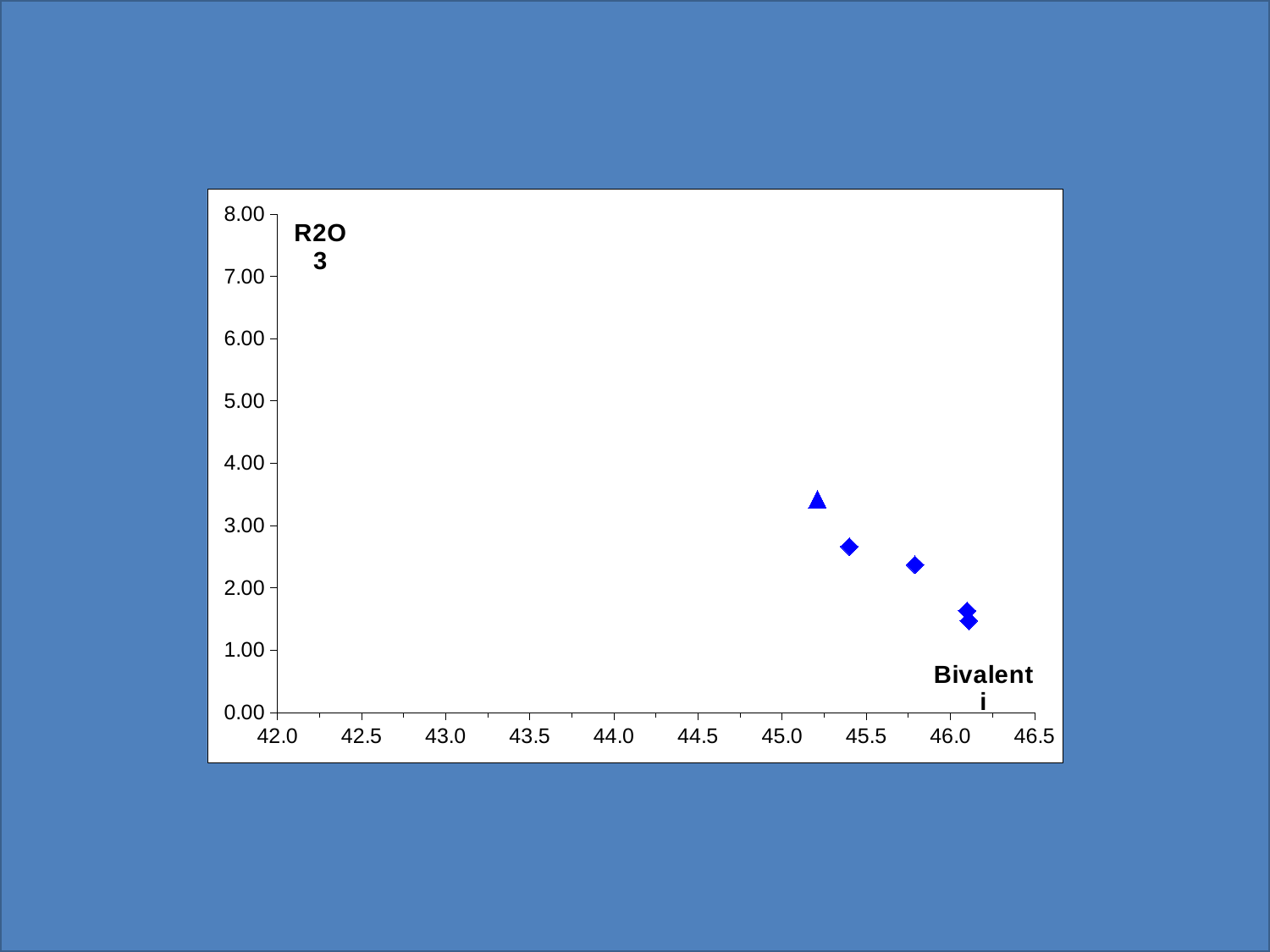
How many data points are plotted on the chart? 5 Is the R2O3 value of the diamond marker near 45.4 on the x axis greater or less than 3.00? less Is the R2O3 value of the diamond marker near 45.8 on the x axis greater or less than 2.00? greater Are the R2O3 values of the two diamond markers near 46.1 on the x axis greater or less than 2.00? less What kind of chart is shown on the slide? scatter chart What label is shown on the vertical axis of the chart? R2O3 How many diamond-shaped markers are plotted on the chart? 4 As the Bivalent i value increases along the x axis, do the R2O3 values rise or fall? fall What is the highest tick value shown on the vertical axis? 8.00 Which has the higher R2O3 value: the triangle marker or the diamond marker near 45.4 on the x axis? the triangle marker